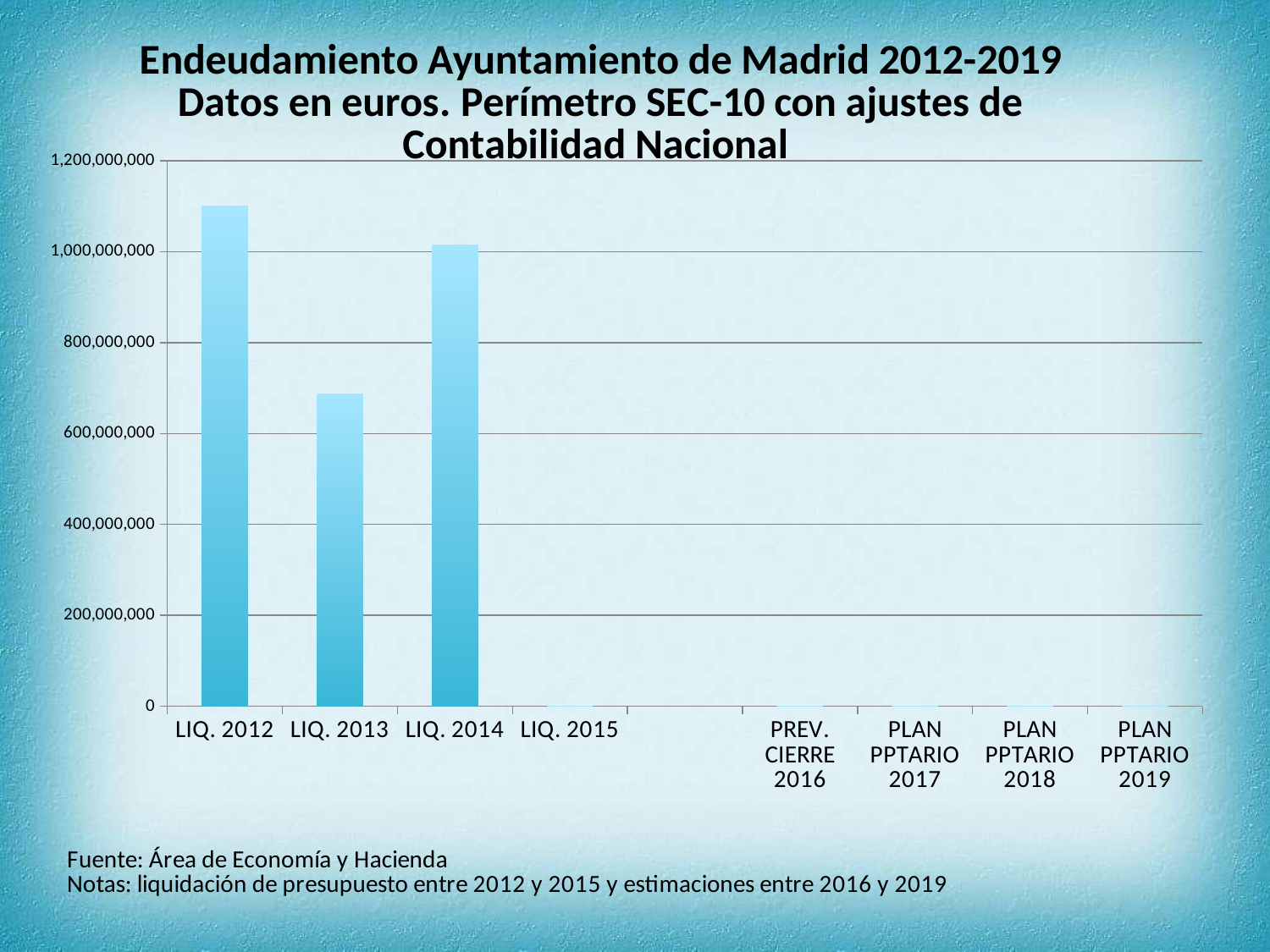
Which is larger, the value for LIQ. 2012 or the value for LIQ. 2013? LIQ. 2012 What kind of chart is shown on the slide? Bar chart What is the first line of the chart title? Endeudamiento Ayuntamiento de Madrid 2012-2019 Which category has the highest value? LIQ. 2012 Is the value for LIQ. 2014 greater or less than 800,000,000? greater Is the value for LIQ. 2013 greater or less than 800,000,000? less Is the value for LIQ. 2012 greater or less than 1,000,000,000? greater Which is larger, the value for LIQ. 2014 or the value for LIQ. 2013? LIQ. 2014 What source is cited below the chart? Área de Economía y Hacienda How many bars clearly rise above zero on the chart? 3 Does the value rise or fall from LIQ. 2012 to LIQ. 2013? fall